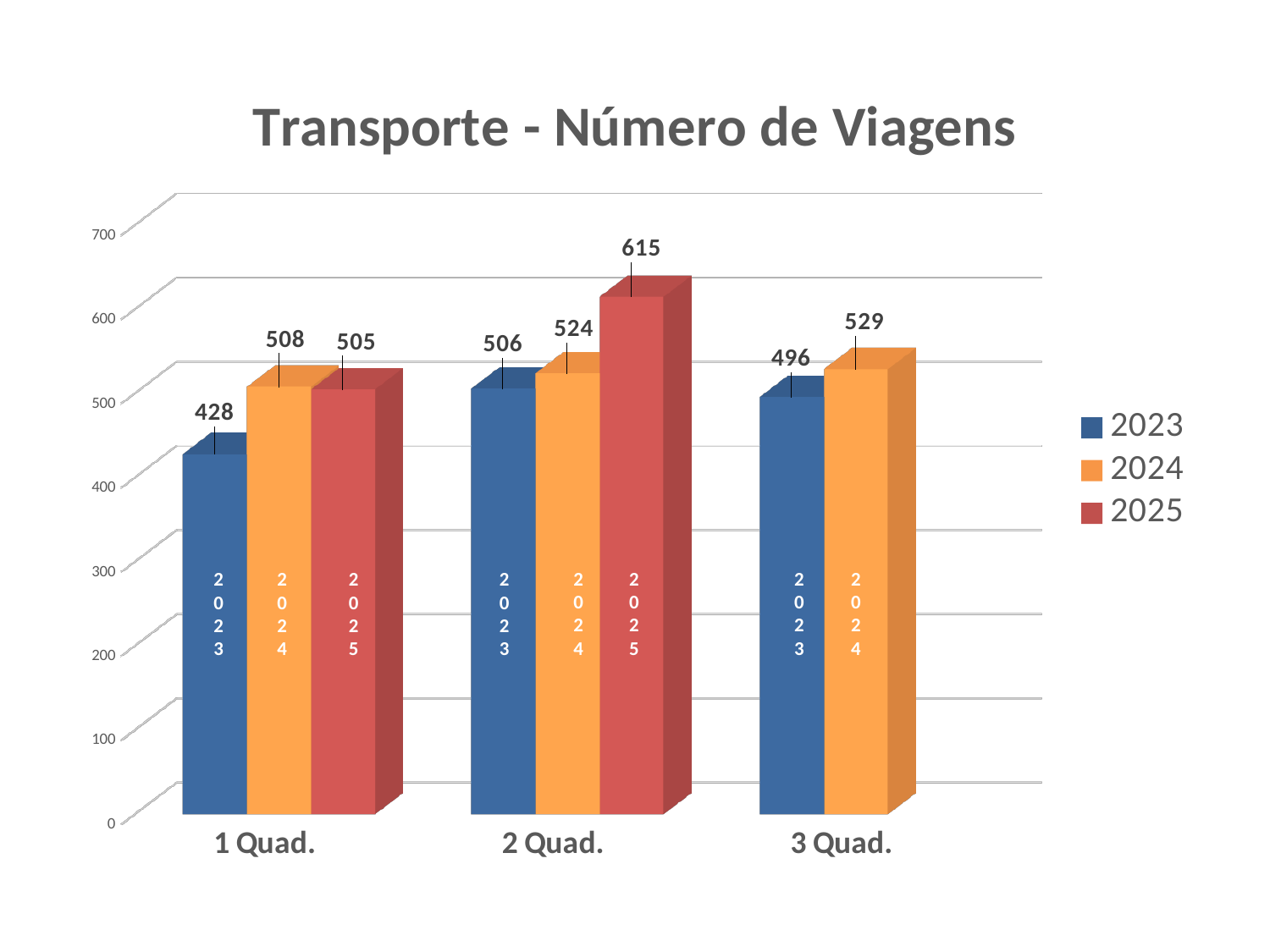
What is the difference between the 2025 and 2023 values in 2 Quad.? 109 What kind of chart is shown on the slide? bar chart Which category has the lowest value for the 2023 series? 1 Quad. How many series does the legend list? 3 What is the value for 2023 in 1 Quad.? 428 Is the value for 2025 in 2 Quad. greater or less than 600? greater What is the title of the chart? Transporte - Número de Viagens What is the value for 2024 in 3 Quad.? 529 Which is larger in 1 Quad.: the 2024 value or the 2023 value? 2024 What is the value for 2025 in 2 Quad.? 615 Which category has the highest value for the 2025 series? 2 Quad. How many categories are shown on the x axis? 3